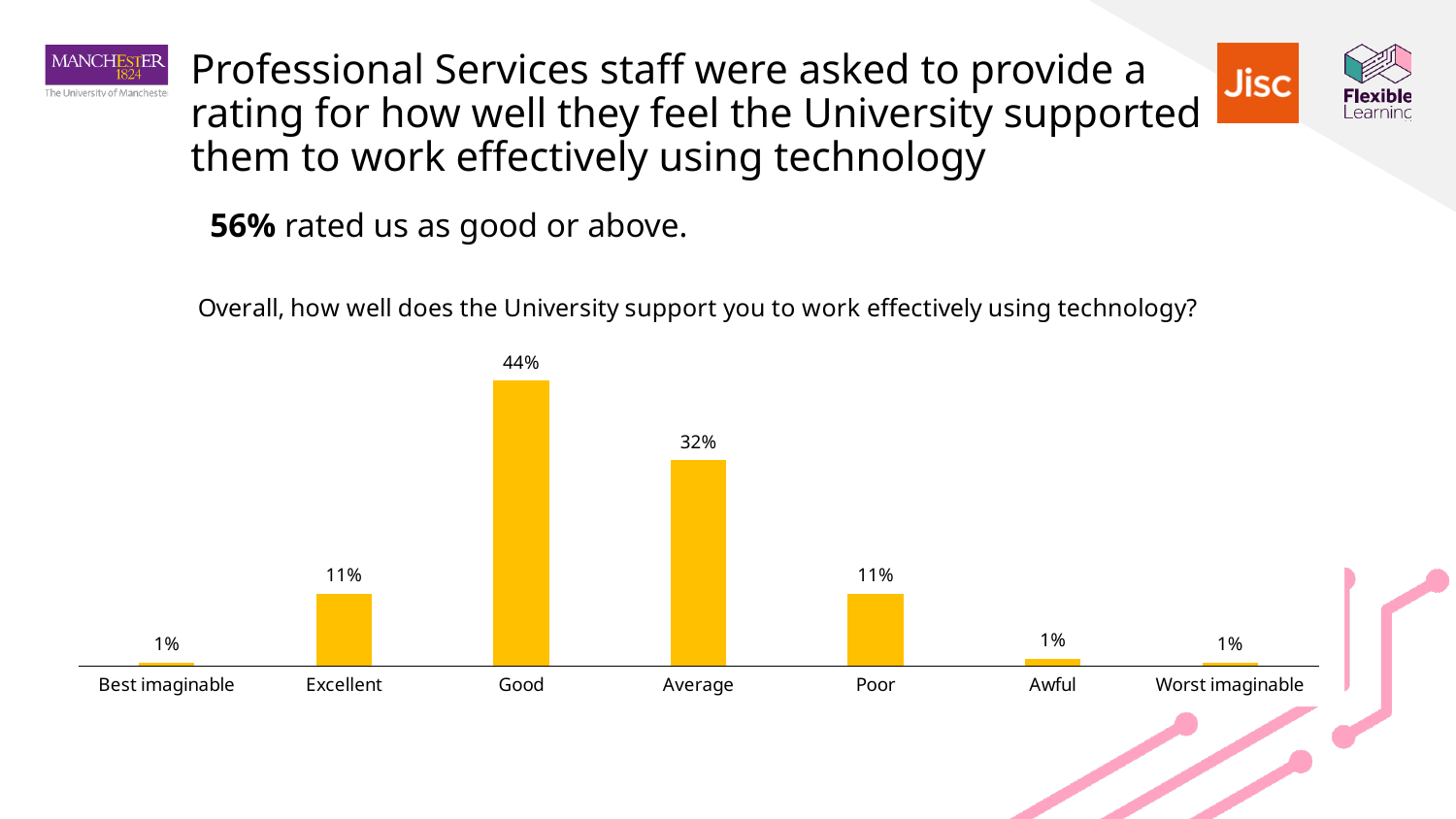
What question is shown as the title of the chart? Overall, how well does the University support you to work effectively using technology? What is the difference in percentage points between the Average and Poor ratings? 21 What percentage of respondents rated the University's support as Excellent? 11% How many rating categories are shown on the x axis of the chart? 7 What kind of chart is shown on the slide? Bar chart Which is larger, the percentage for Excellent or the percentage for Average? Average What is the combined percentage of the Best imaginable, Excellent and Good ratings? 56% Which rating category has the highest percentage? Good What percentage of respondents rated the University's support as Good? 44% What is the difference in percentage points between the Good and Average ratings? 12 What percentage of respondents rated the University's support as Average? 32% What percentage of respondents rated the University's support as Worst imaginable? 1%